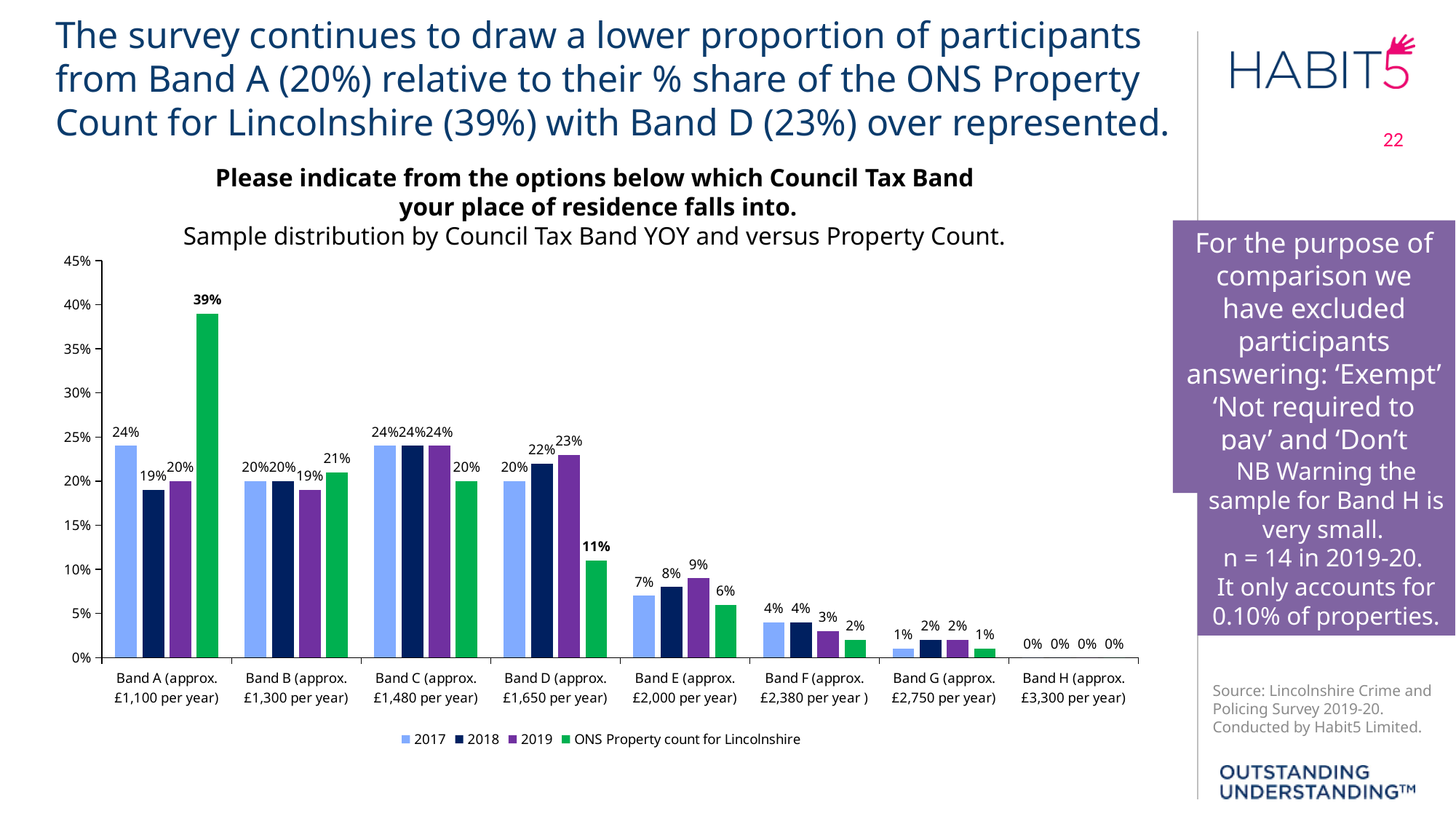
How many series does the legend list? 4 What is the ONS Property count for Lincolnshire value for Band A? 39% Do the 2018 values rise or fall from Band D to Band H? Fall What is the difference between the ONS Property count for Lincolnshire value and the 2019 value for Band A? 19 percentage points For Band D, which is larger: the 2019 value or the ONS Property count for Lincolnshire value? 2019 What is the 2018 value for Band G? 2% How many council tax band categories are shown on the x axis? 8 Which series is shown in green in the legend? ONS Property count for Lincolnshire What is the 2017 value for Band E? 7% What kind of chart is shown on the slide? Bar chart What is the 2019 value for Band D? 23% Which council tax band has the highest ONS Property count for Lincolnshire value? Band A